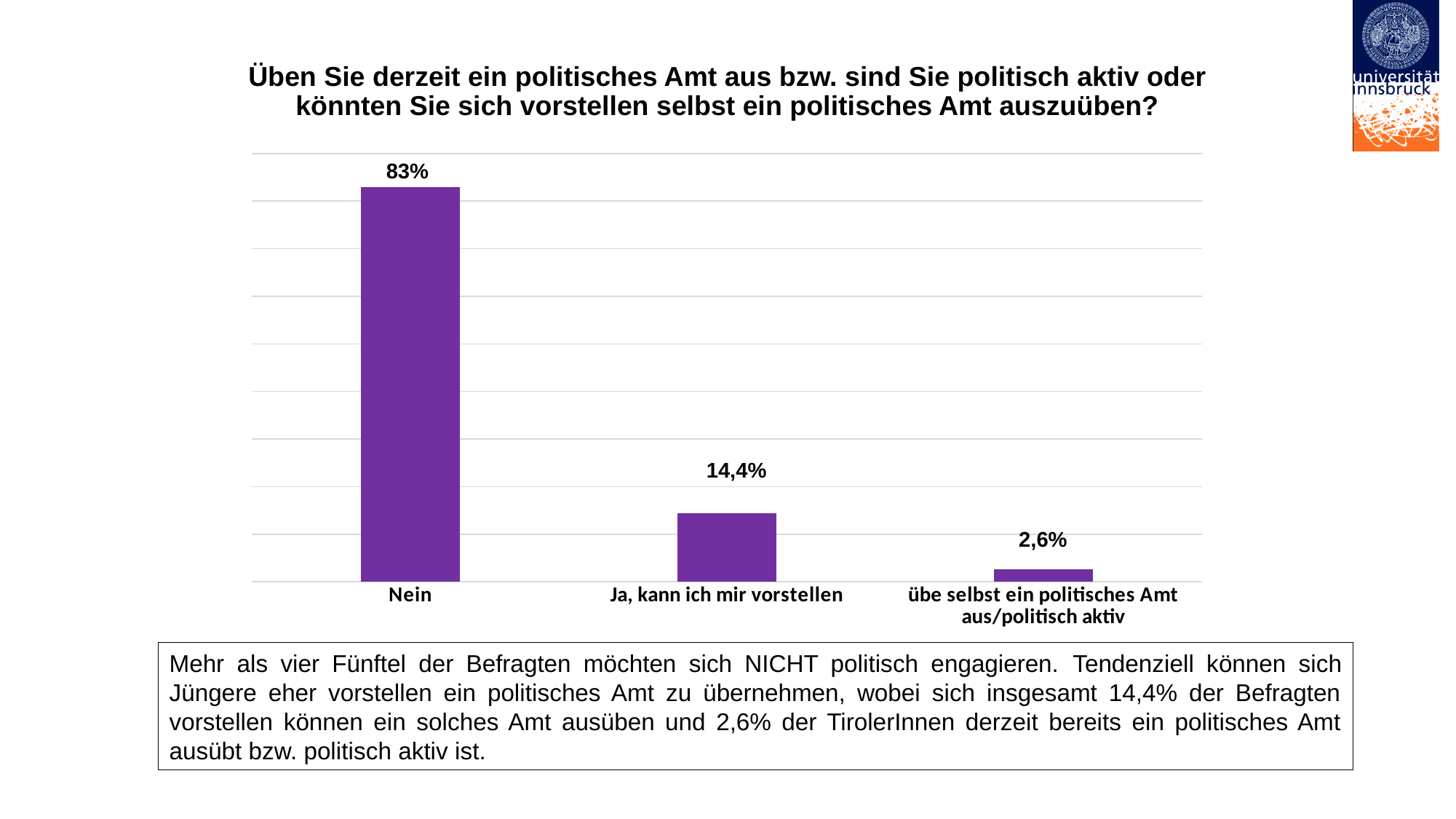
Do the values rise or fall from left to right across the categories? Fall What colour are the bars in the chart? Purple What is the difference between the values for "Nein" and "Ja, kann ich mir vorstellen"? 68,6% What is the value for "Ja, kann ich mir vorstellen"? 14,4% What is the value for "übe selbst ein politisches Amt aus/politisch aktiv"? 2,6% How many categories are shown in the chart? 3 Which is larger, the value for "Ja, kann ich mir vorstellen" or the value for "übe selbst ein politisches Amt aus/politisch aktiv"? Ja, kann ich mir vorstellen What kind of chart is shown on the slide? Bar chart Which category has the lowest value? übe selbst ein politisches Amt aus/politisch aktiv What is the difference between the values for "Ja, kann ich mir vorstellen" and "übe selbst ein politisches Amt aus/politisch aktiv"? 11,8% Which category has the highest value? Nein What is the value for "Nein"? 83%